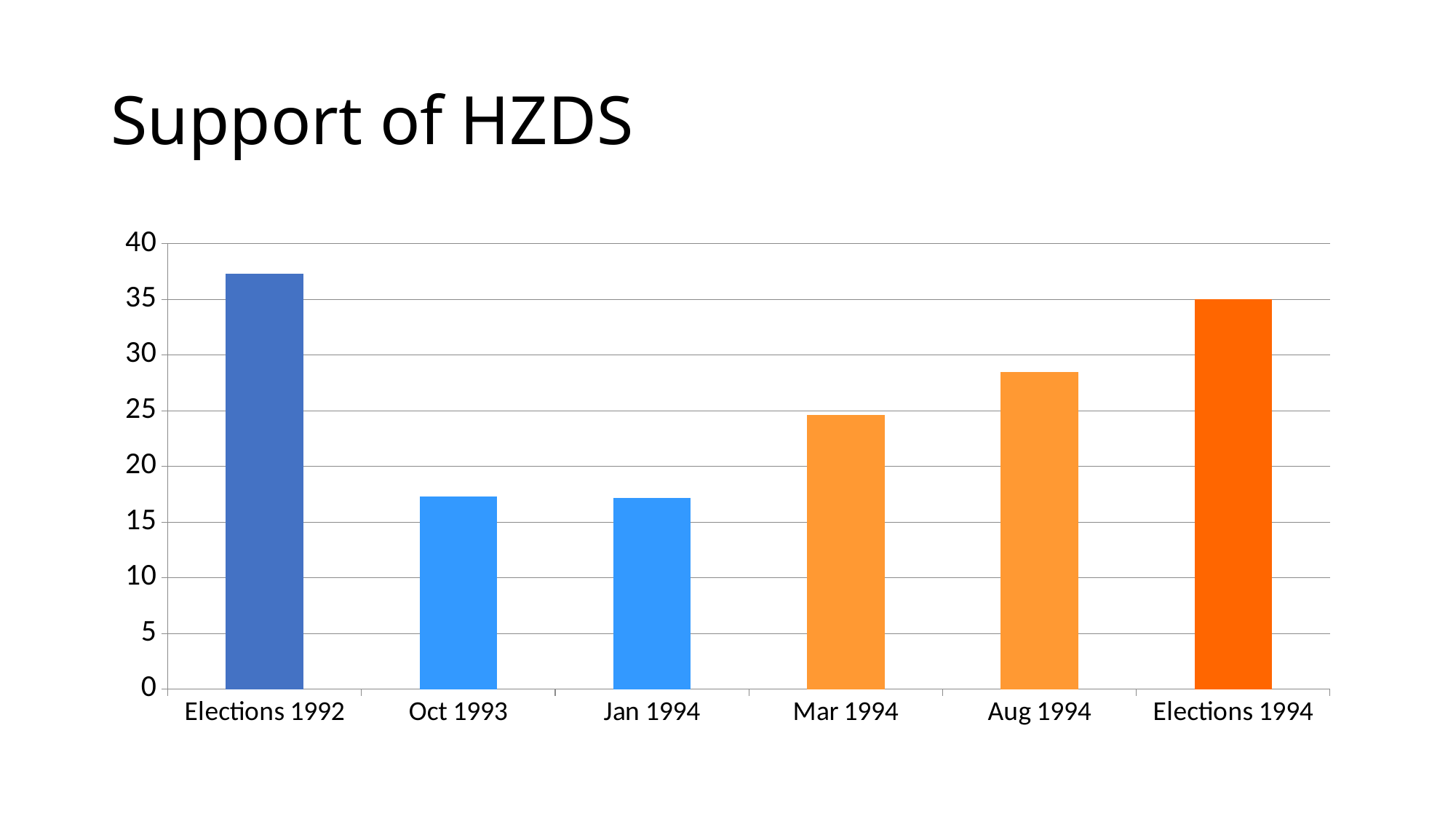
How many categories are shown on the x axis? 6 Is the value for Aug 1994 greater or less than 25? greater Is the value for Oct 1993 greater or less than 20? less What is the title of the chart? Support of HZDS Is the value for Elections 1994 greater or less than 30? greater Do the values rise or fall from Oct 1993 to Elections 1994? rise Which is larger, the value for Aug 1994 or the value for Mar 1994? Aug 1994 What type of chart is shown on the slide? bar chart Which category has the highest value? Elections 1992